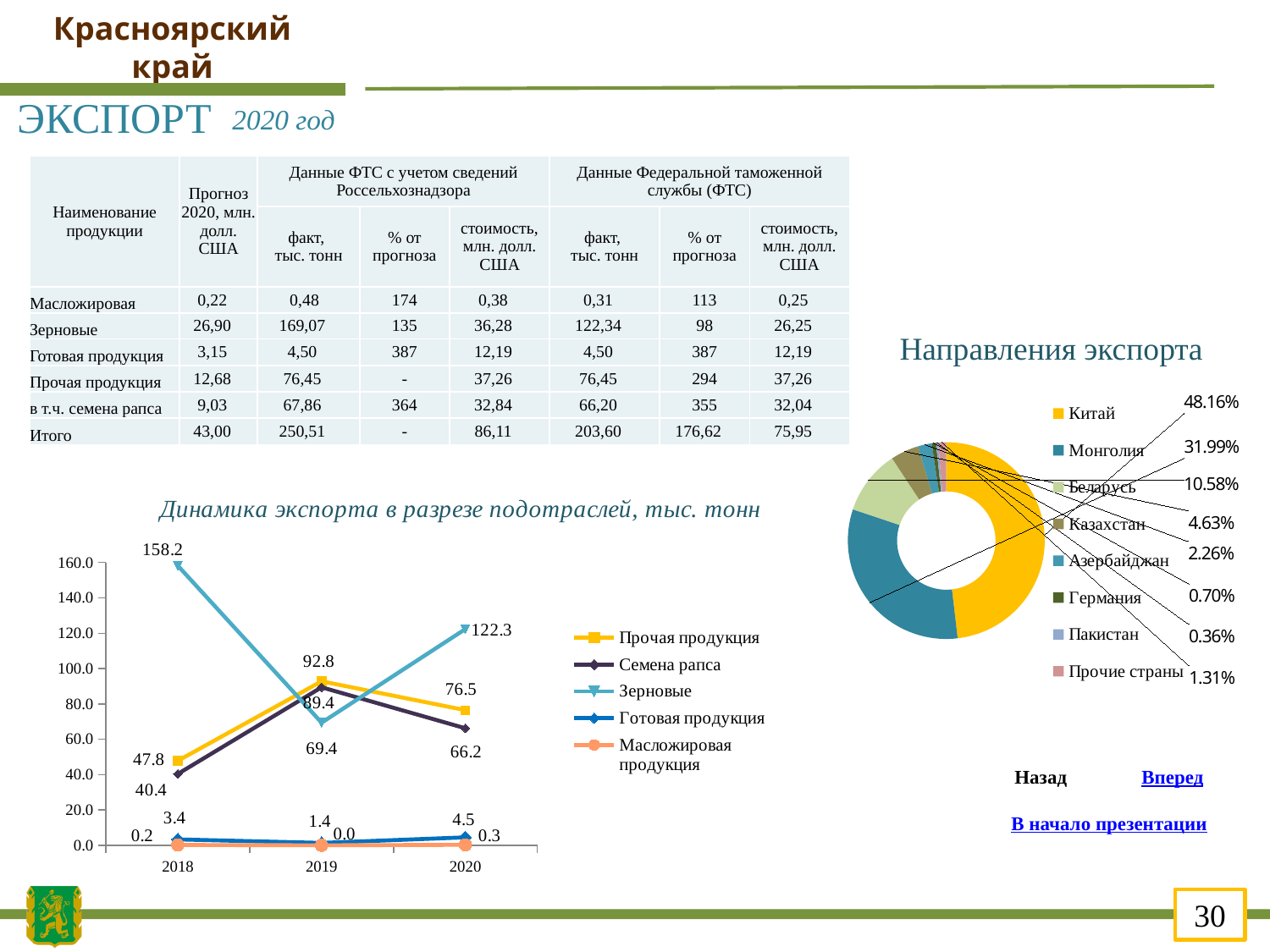
What kind of chart is 'Динамика экспорта в разрезе подотраслей, тыс. тонн'? Line chart On the chart 'Динамика экспорта в разрезе подотраслей, тыс. тонн', what is the difference between the Зерновые values in 2018 and 2019? 88.8 On the chart 'Динамика экспорта в разрезе подотраслей, тыс. тонн', what is the value for Зерновые in 2018? 158.2 On the chart 'Динамика экспорта в разрезе подотраслей, тыс. тонн', how many series does the legend list? 5 On the chart 'Динамика экспорта в разрезе подотраслей, тыс. тонн', what is the value for Прочая продукция in 2019? 92.8 On the chart 'Динамика экспорта в разрезе подотраслей, тыс. тонн', which year has the lowest value for Готовая продукция? 2019 On the chart 'Направления экспорта', what share does Китай have? 48.16% On the chart 'Направления экспорта', how many countries/categories does the legend list? 8 On the chart 'Динамика экспорта в разрезе подотраслей, тыс. тонн', which year has the highest value for Зерновые? 2018 On the chart 'Динамика экспорта в разрезе подотраслей, тыс. тонн', does the value for Семена рапса rise or fall from 2019 to 2020? Fall On the chart 'Динамика экспорта в разрезе подотраслей, тыс. тонн', what is the value for Семена рапса in 2020? 66.2 On the chart 'Динамика экспорта в разрезе подотраслей, тыс. тонн', which is larger in 2020: Зерновые or Прочая продукция? Зерновые